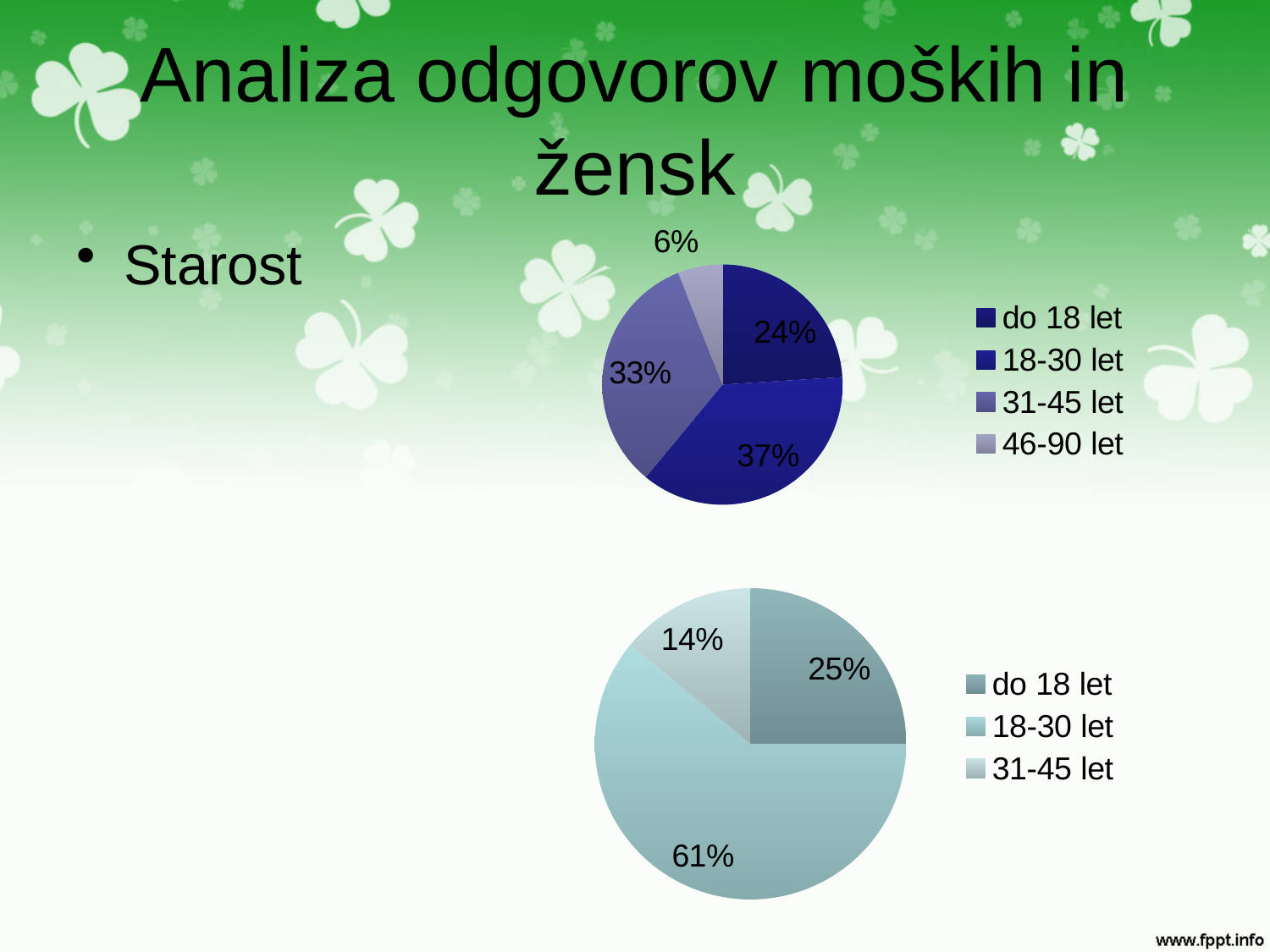
In the lower pie chart, what share is shown for the 31-45 let slice? 14% In the upper pie chart, which age group has the largest slice? 18-30 let In the lower pie chart, how many entries does the legend list? 3 In the upper pie chart, how many slices are there? 4 In the lower pie chart, which is larger: the do 18 let slice or the 31-45 let slice? do 18 let In the lower pie chart, what share is shown for the 18-30 let slice? 61% In the upper pie chart, which age group has the smallest slice? 46-90 let In the upper pie chart, what is the difference between the 18-30 let and do 18 let shares? 13% In the upper pie chart, what share is shown for the 18-30 let slice? 37% In the upper pie chart, what share is shown for the 46-90 let slice? 6% What type of chart is the lower chart on the slide? Pie chart In the lower pie chart, which age group has the smallest slice? 31-45 let